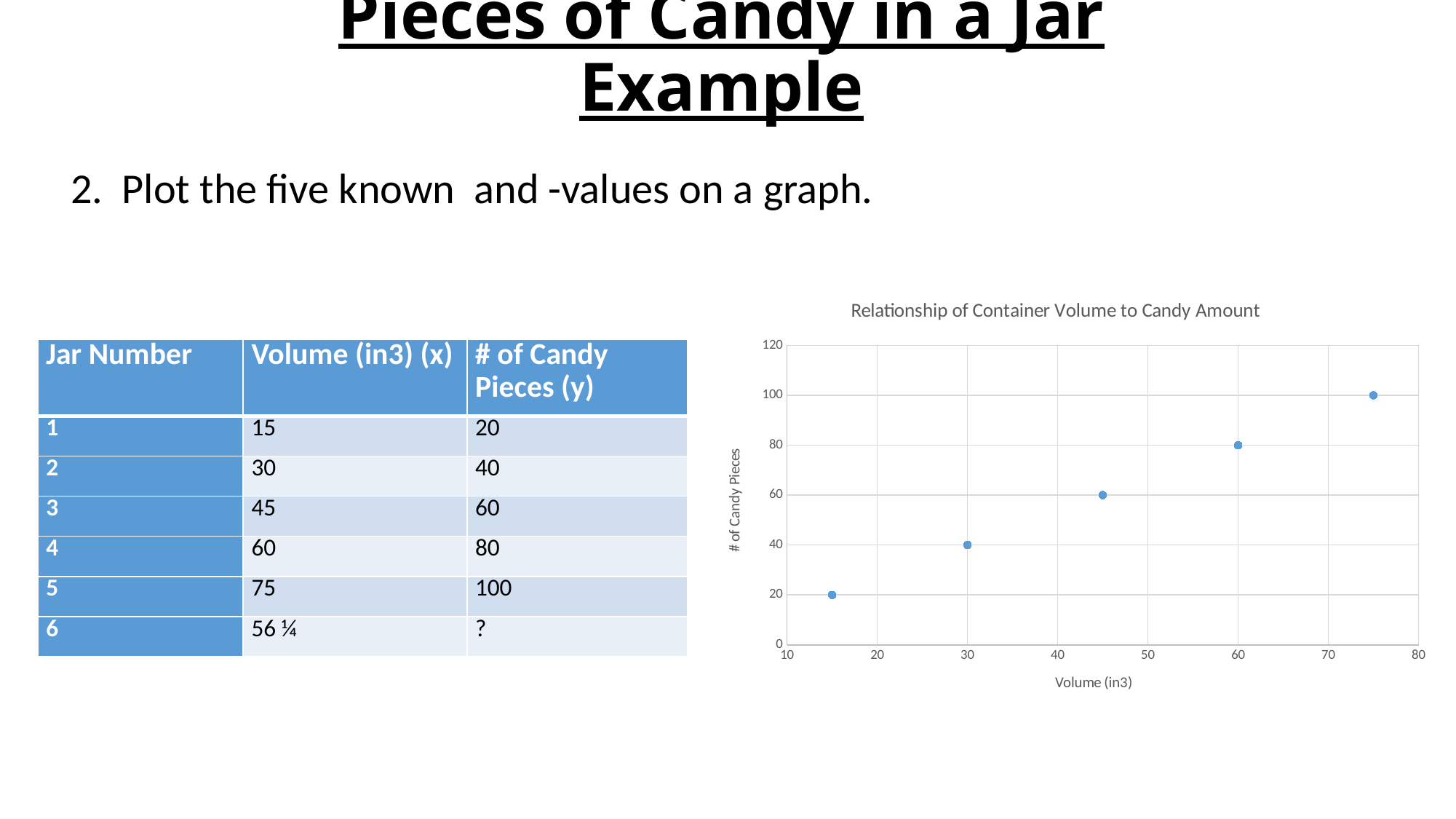
Is the number of candy pieces for the point at 75 in3 greater or less than 80? greater What is the highest number of candy pieces plotted on the chart? 100 What is the title of the chart? Relationship of Container Volume to Candy Amount What is the lowest number of candy pieces plotted on the chart? 20 What is the number of candy pieces plotted for a volume of 30 in3? 40 Do the plotted values rise or fall as volume increases along the x axis? rise What kind of chart is shown on the slide? scatter chart Which point has more candy pieces: the one at 30 in3 or the one at 60 in3? 60 in3 What is the number of candy pieces plotted for a volume of 60 in3? 80 How many data points are plotted on the chart? 5 What is the difference in candy pieces between the point at 60 in3 and the point at 30 in3? 40 What is the label of the x axis of the chart? Volume (in3)